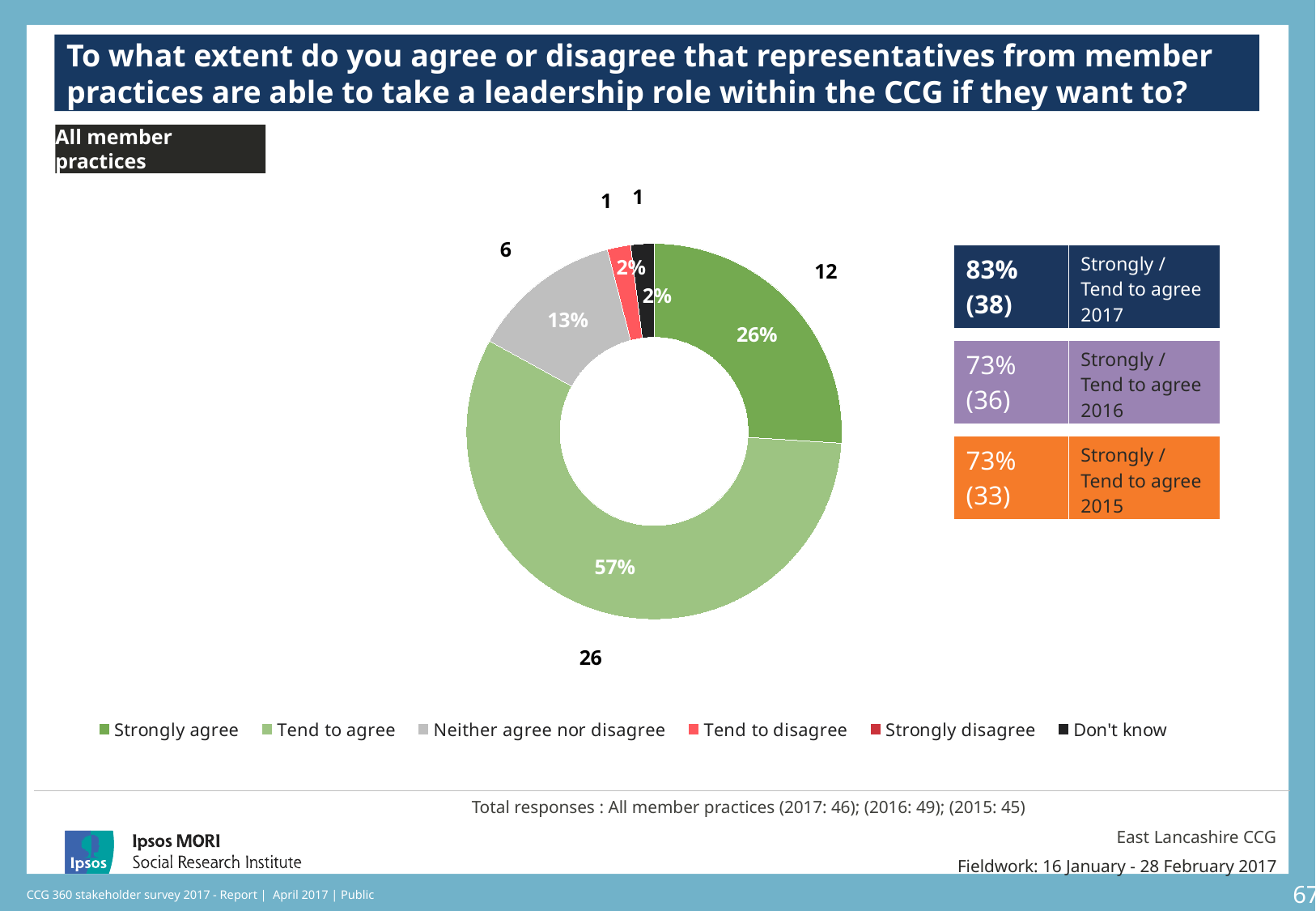
What is the difference in percentage points between 'Tend to agree' and 'Strongly agree'? 31 How many respondents tend to agree, according to the count label next to the chart? 26 What kind of chart is shown on the slide? Donut (pie) chart What percentage of respondents answered 'Don't know'? 2% What was the combined 'Strongly / Tend to agree' percentage in 2015? 73% Which response category has the largest share of the chart? Tend to agree Which is larger: the share for 'Strongly agree' or the share for 'Neither agree nor disagree'? Strongly agree What percentage of respondents said they tend to agree? 57% How many response categories does the legend list? 6 What was the combined 'Strongly / Tend to agree' percentage in 2017? 83% What percentage of respondents neither agree nor disagree? 13% What percentage of respondents strongly agree? 26%